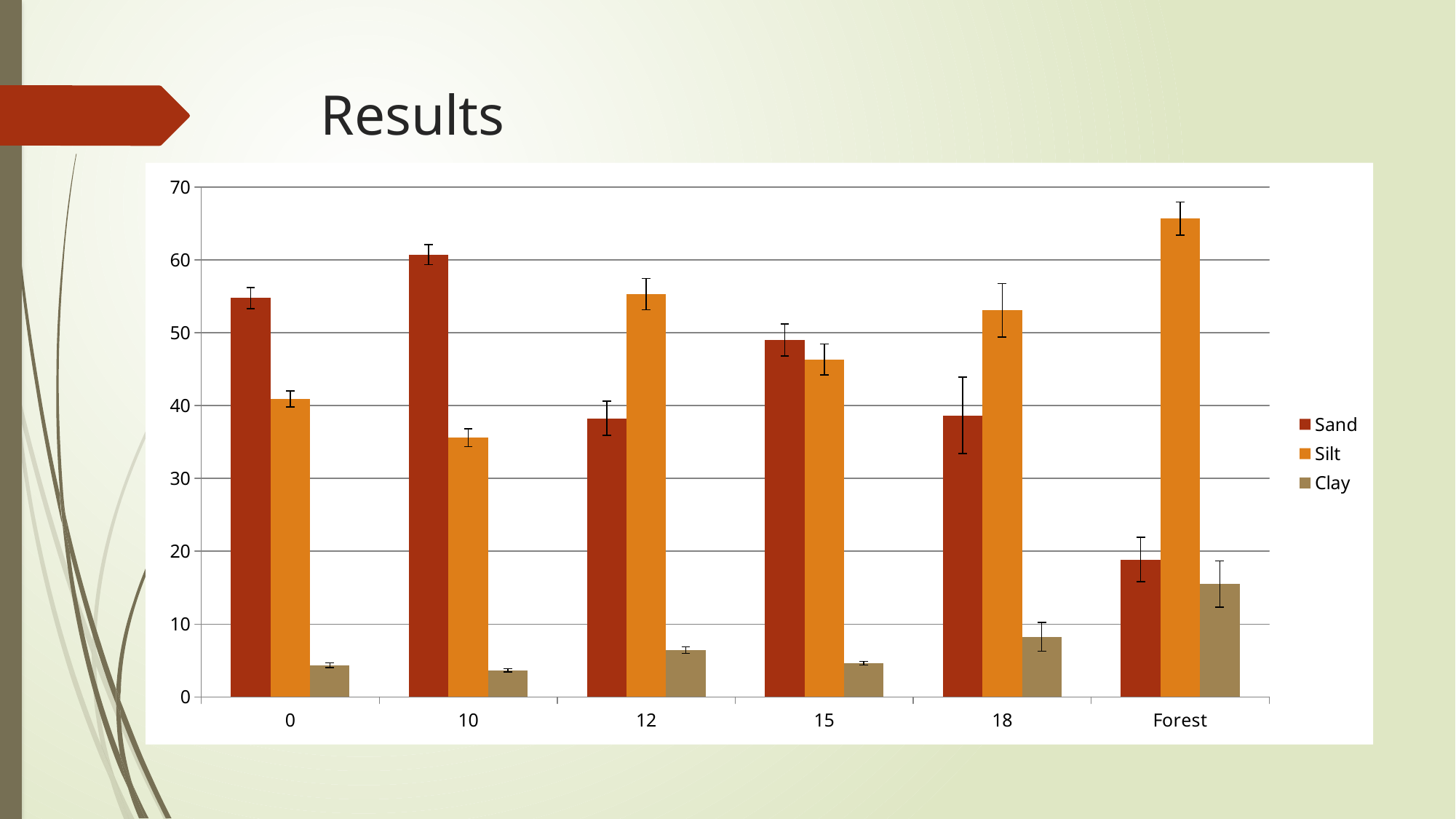
Which category has the highest Clay value? Forest What are the three entries listed in the legend? Sand, Silt, Clay How many series does the legend list? 3 Is the Silt value for category 10 greater or less than 40? less Which category has the highest Silt value? Forest Is the Clay value for Forest greater or less than 10? greater How many categories are shown on the x axis? 6 For category 12, which is larger, Sand or Silt? Silt Which category has the lowest Sand value? Forest Which category has the highest Sand value? 10 What kind of chart is shown on the slide? bar chart Is the Sand value for category 0 greater or less than 50? greater